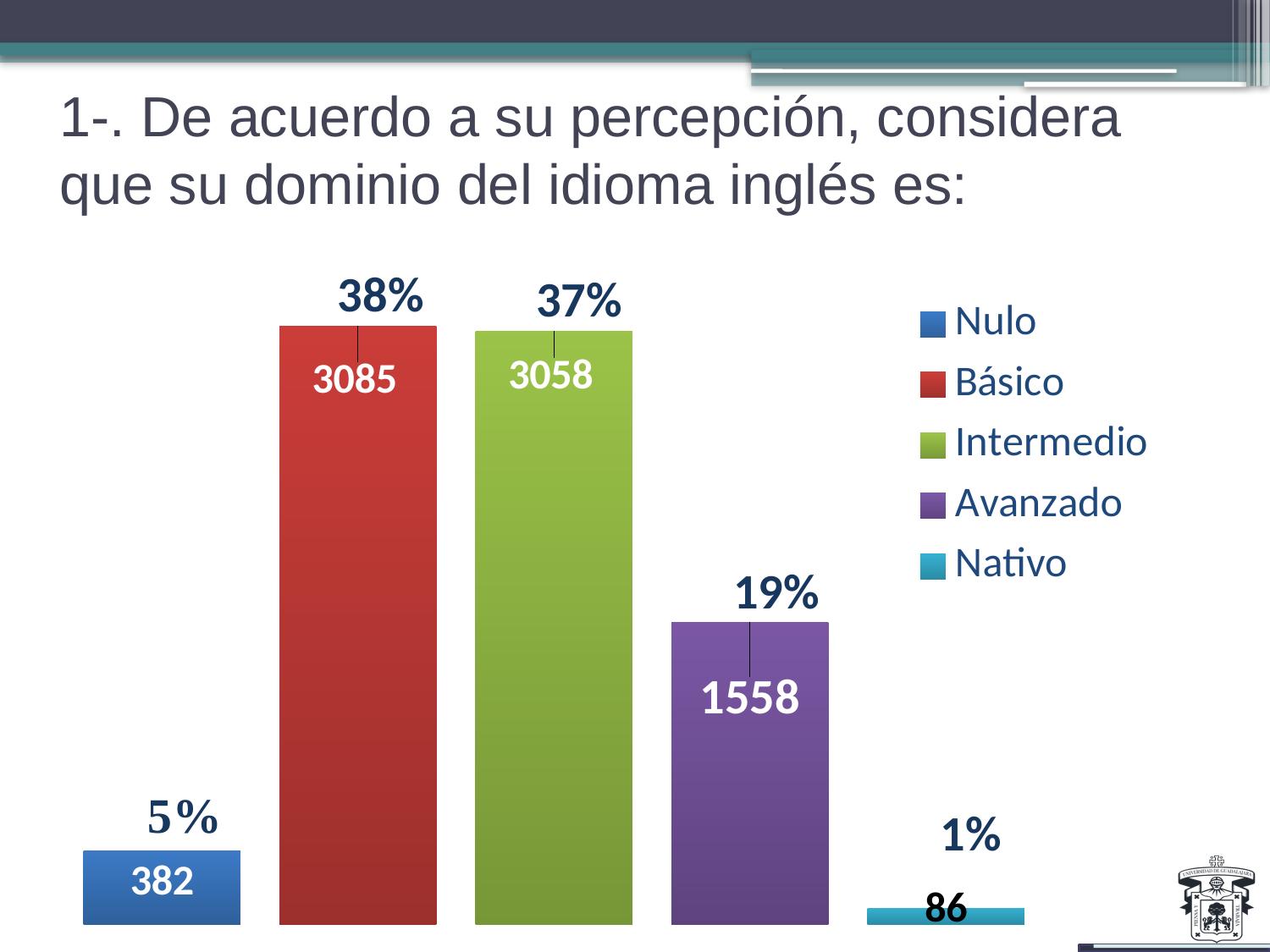
What kind of chart is shown on the slide? bar chart Which has a larger count, Avanzado or Nulo? Avanzado How many categories does the legend list? 5 What percentage is shown for Avanzado? 19% How many bars are plotted in the chart? 5 Which category has the lowest count? Nativo What is the count shown for Nulo? 382 What is the difference between the counts for Básico and Intermedio? 27 What percentage is shown for Nativo? 1% What is the count shown for Intermedio? 3058 Which category has the highest count? Básico What is the count shown for Básico? 3085